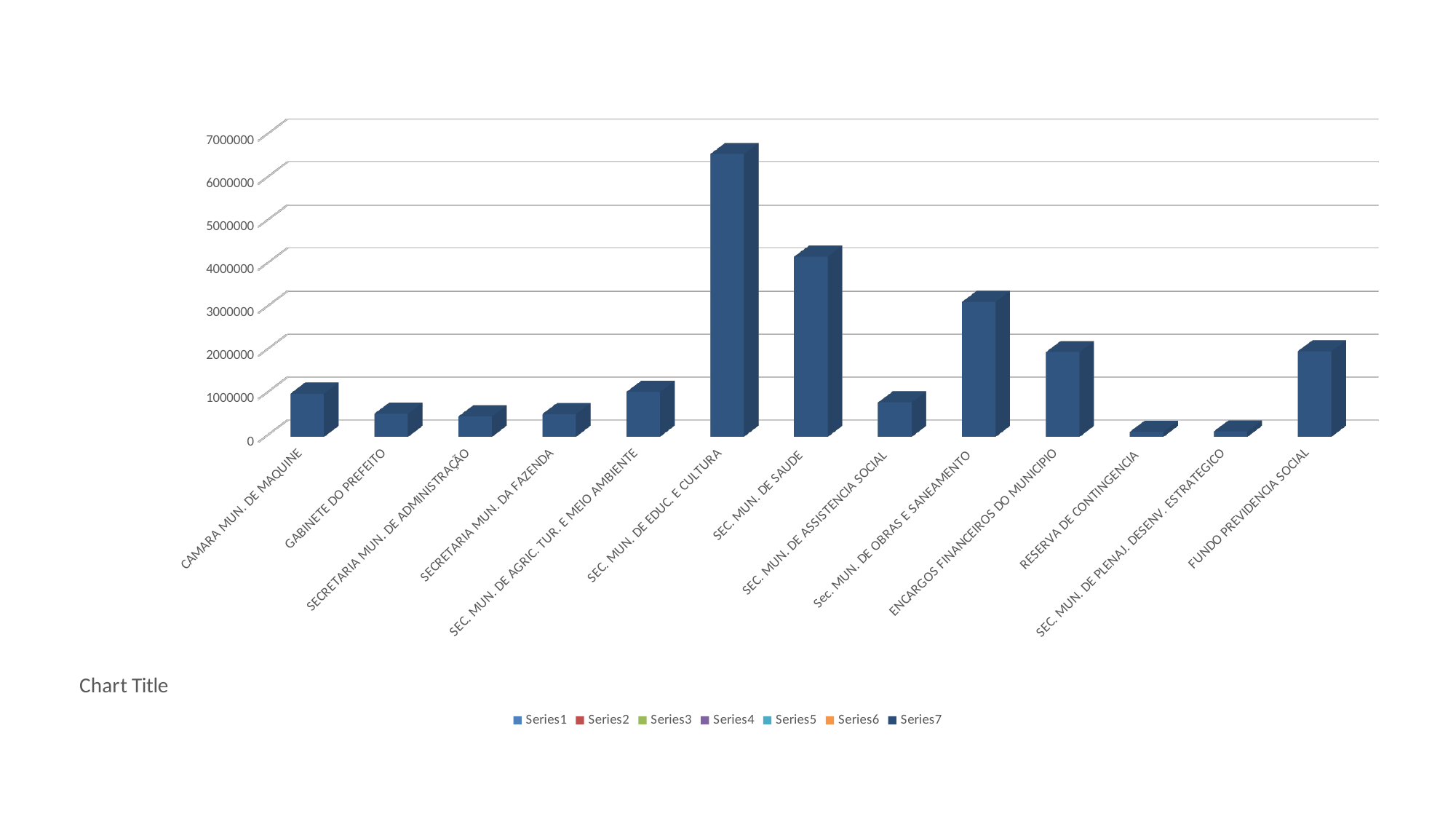
Is the value for Sec. MUN. DE OBRAS E SANEAMENTO greater or less than 2000000? greater What kind of chart is shown on the slide? bar chart What is the title shown for the chart? Chart Title Is the value for SEC. MUN. DE EDUC. E CULTURA greater or less than 6000000? greater Which is larger, the value for SEC. MUN. DE EDUC. E CULTURA or the value for SEC. MUN. DE SAUDE? SEC. MUN. DE EDUC. E CULTURA Is the value for ENCARGOS FINANCEIROS DO MUNICIPIO greater or less than 3000000? less Which is larger, the value for Sec. MUN. DE OBRAS E SANEAMENTO or the value for SEC. MUN. DE ASSISTENCIA SOCIAL? Sec. MUN. DE OBRAS E SANEAMENTO How many categories are plotted along the x axis? 13 Which category has the highest bar? SEC. MUN. DE EDUC. E CULTURA How many series does the legend list? 7